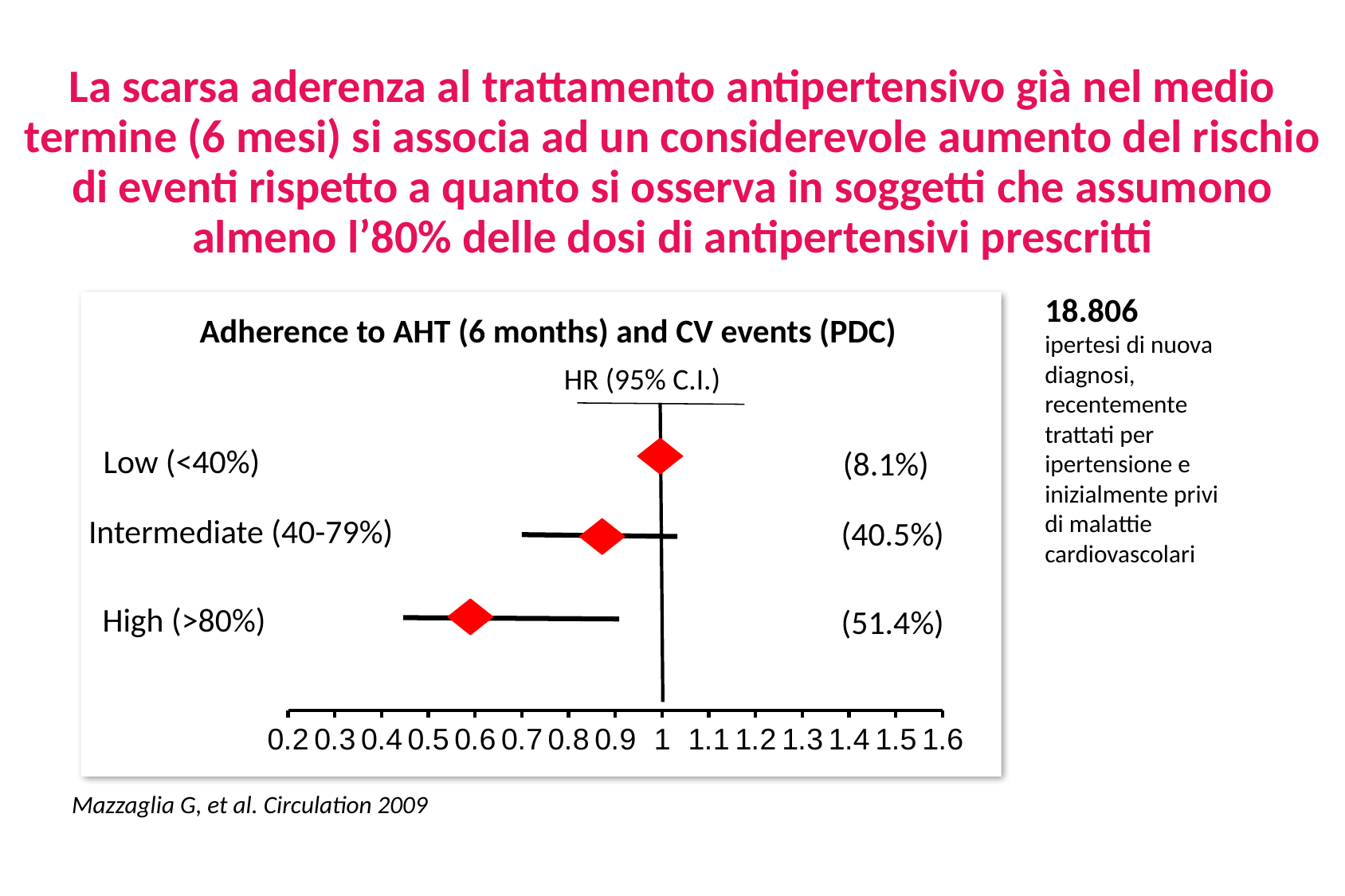
Is the hazard ratio for the High (>80%) adherence group greater or less than 0.7? less What percentage is shown in parentheses for the Low (<40%) adherence group? 8.1% Which adherence group has the highest percentage shown in parentheses? High (>80%) Which group has the lower hazard ratio, High (>80%) or Low (<40%)? High (>80%) What percentage is shown in parentheses for the Intermediate (40-79%) adherence group? 40.5% What is the title of the chart on the slide? Adherence to AHT (6 months) and CV events (PDC) What percentage is shown in parentheses for the High (>80%) adherence group? 51.4% Is the hazard ratio for the Intermediate (40-79%) adherence group greater or less than 1? less How many adherence categories are plotted in the chart? 3 What is the difference between the percentages shown for the High (>80%) and Low (<40%) groups? 43.3 percentage points What is the label of the horizontal axis measure shown above the plot? HR (95% C.I.) Which adherence group has the lowest percentage shown in parentheses? Low (<40%)